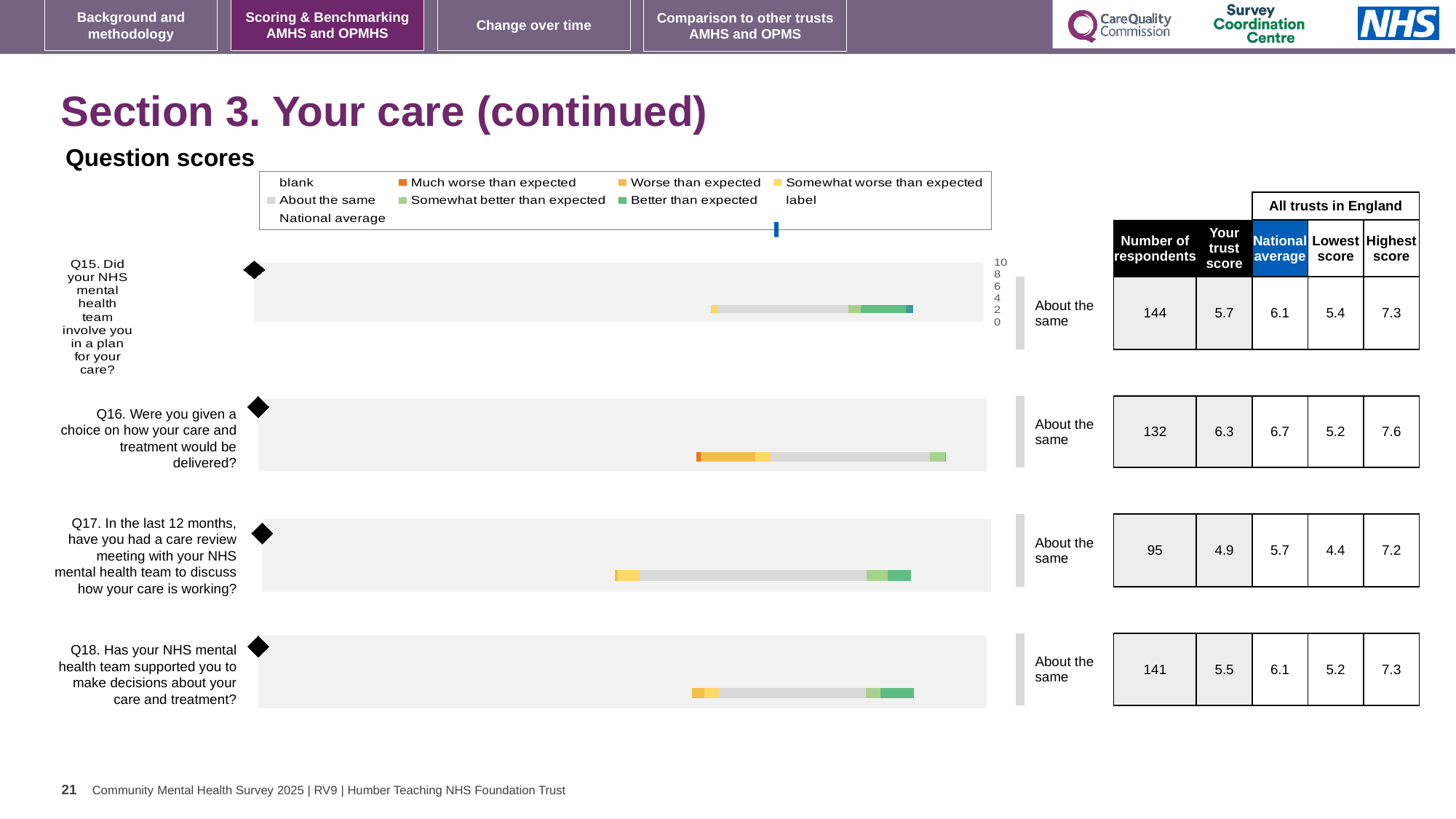
What kind of chart is used to show the question scores for Q15 to Q18? Stacked horizontal bar chart What is the national average shown for Q16 (Were you given a choice on how your care and treatment would be delivered?)? 6.7 Which is larger for Q18: the trust score or the national average? National average What is the 'Your trust score' shown for Q15 (Did your NHS mental health team involve you in a plan for your care?)? 5.7 What benchmark category label is shown next to the bar for Q16? About the same How many survey questions (Q15 to Q18) have a bar chart on this slide? 4 What is the difference between the national average and the trust score for Q15? 0.4 Which legend entry is shown in orange, representing the worst comparison category? Much worse than expected What is the highest score across all trusts in England shown for Q18? 7.3 Which question (Q15 to Q18) has the lowest 'Your trust score'? Q17 How many respondents are shown for Q17 (care review meeting in the last 12 months)? 95 Which question (Q15 to Q18) has the highest 'Your trust score'? Q16